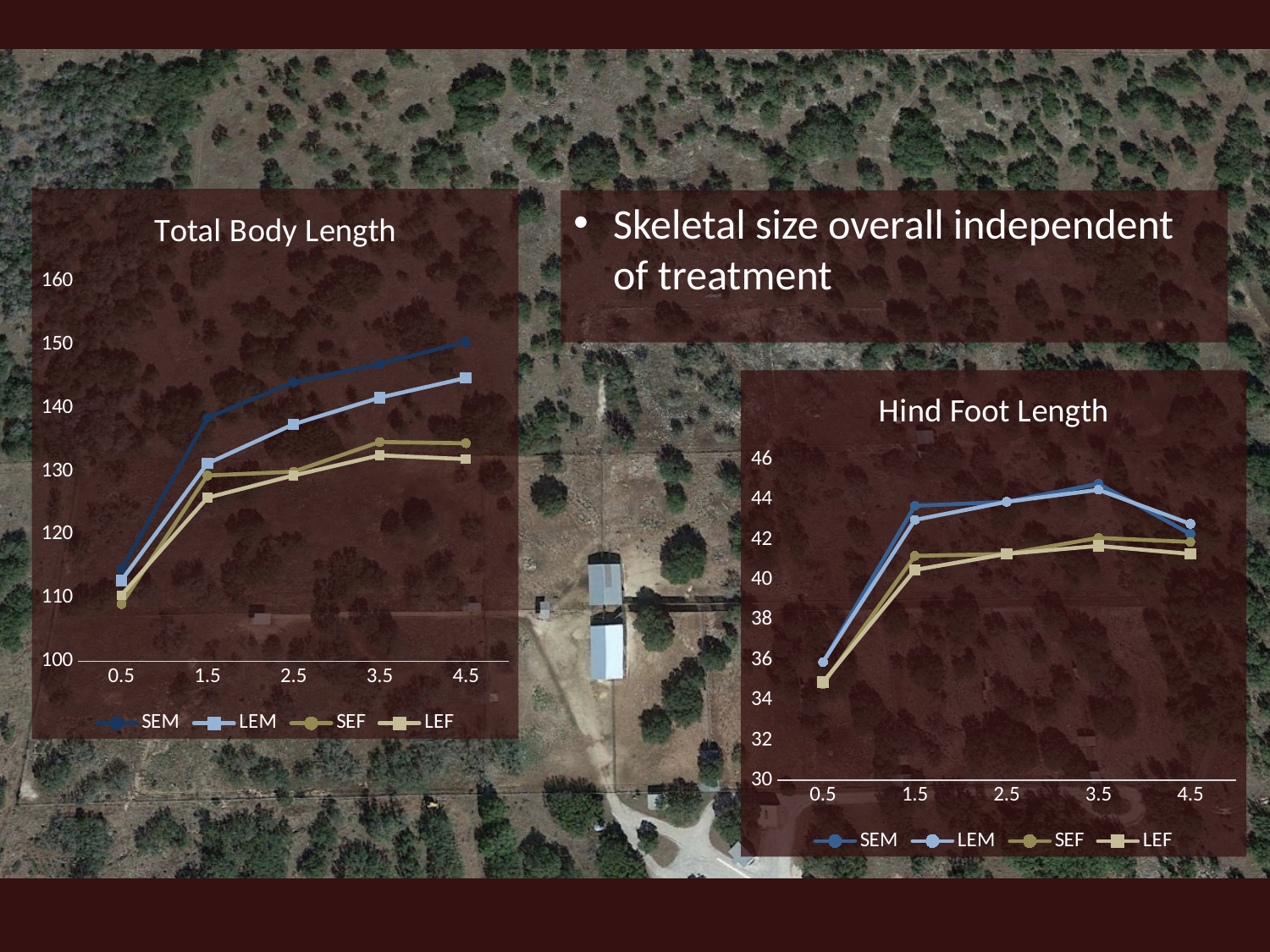
How many series does the legend of the Hind Foot Length chart list? 4 In the Hind Foot Length chart, which is larger at 2.5: LEM or LEF? LEM In the Total Body Length chart, which series has the highest value at 4.5? SEM In the Total Body Length chart, is the value for SEM at 4.5 greater or less than 140? greater What kind of chart is the Total Body Length chart? line chart In the Hind Foot Length chart, is the value for LEF at 0.5 greater or less than 36? less In the Total Body Length chart, which is larger at 3.5: LEM or SEF? LEM In the Total Body Length chart, does the SEM series rise or fall from 0.5 to 4.5? rise How many points along the x axis does the Total Body Length chart have? 5 What is the title of the chart on the right side of the slide? Hind Foot Length In the Hind Foot Length chart, is the value for SEM at 3.5 greater or less than 44? greater